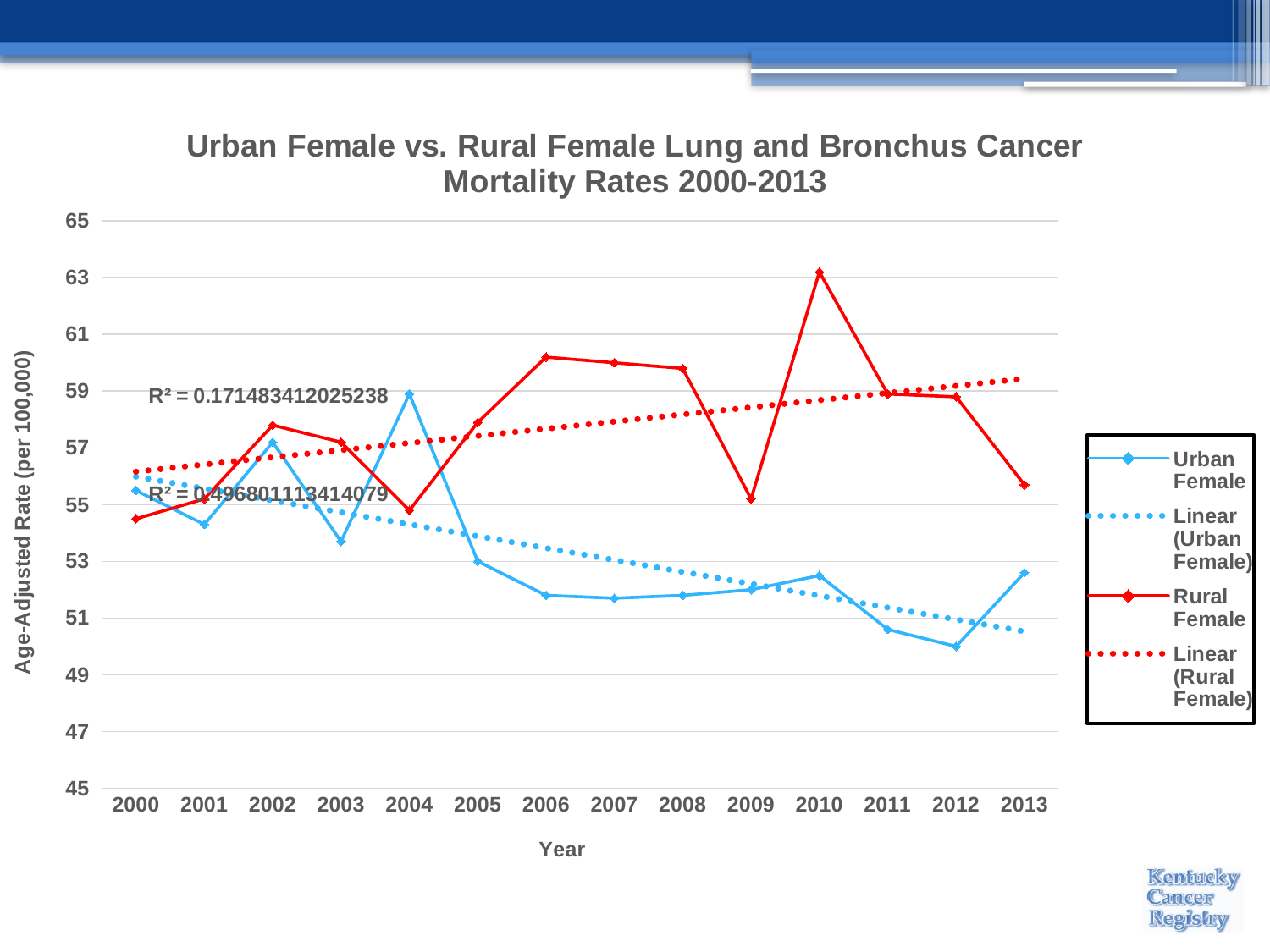
In which year is the Urban Female mortality rate lowest? 2012 Is the Rural Female value for 2006 greater or less than 59? greater What is the label on the y axis of the chart? Age-Adjusted Rate (per 100,000) Is the Urban Female value for 2012 greater or less than 51? less Is the Rural Female value for 2010 greater or less than 61? greater In 2006, which series has the higher mortality rate, Urban Female or Rural Female? Rural Female In which year is the Urban Female mortality rate highest? 2004 In which year is the Rural Female mortality rate highest? 2010 How many years are plotted along the x axis? 14 How many entries does the legend list? 4 What kind of chart is shown on the slide? line chart Does the Linear (Urban Female) trend line rise or fall from 2000 to 2013? fall